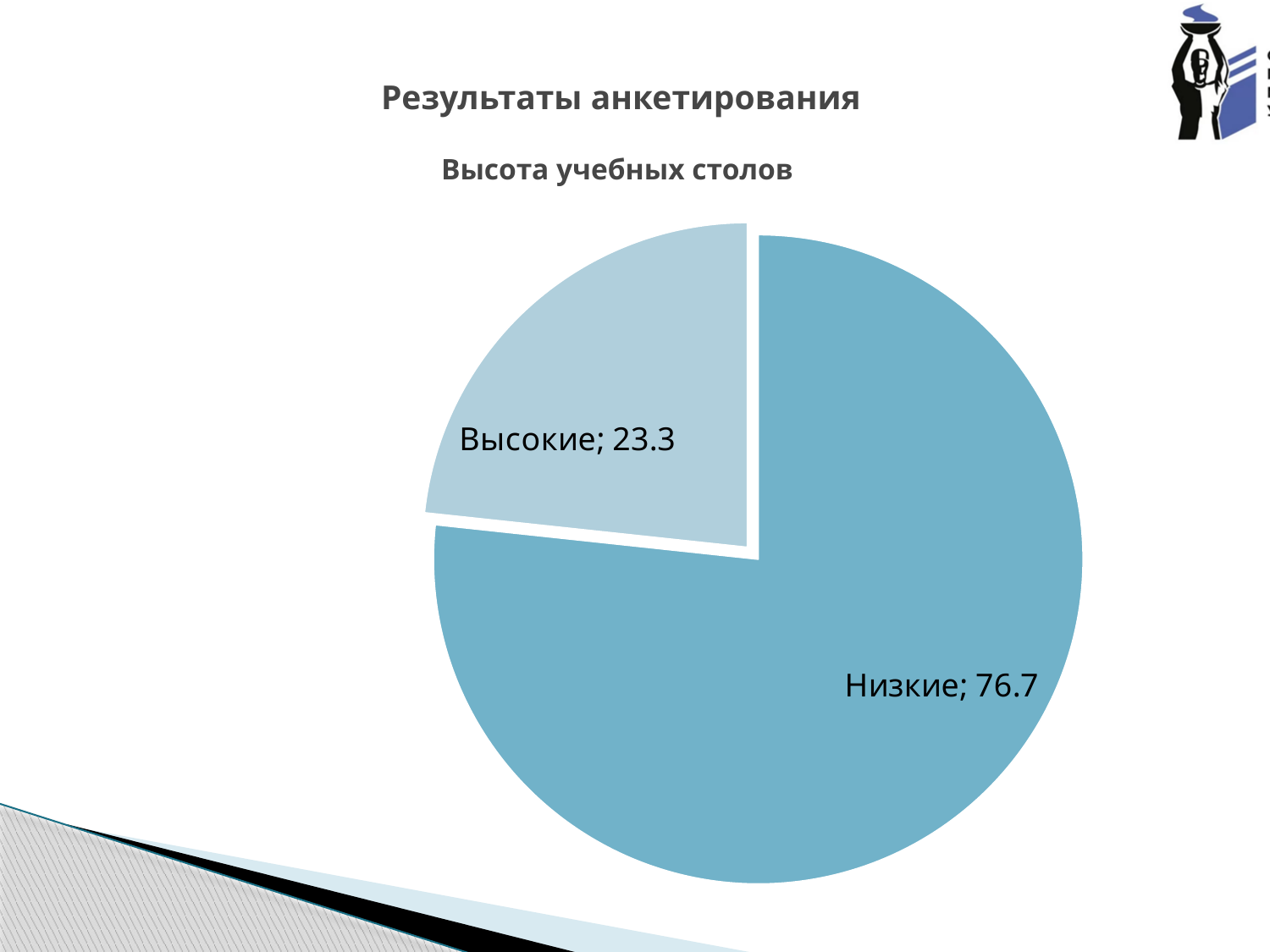
What type of chart is shown on the slide? pie chart What is the difference between the values for Низкие and Высокие? 53.4 How many slices does the pie chart have? 2 Which category has the smallest slice? Высокие What is the total of the two slice values? 100 Which category has the largest slice? Низкие Which slice is pulled out (exploded) from the pie? Высокие What is the value for Высокие? 23.3 What is the value for Низкие? 76.7 What is the title of the chart? Высота учебных столов Which is larger, the value for Высокие or the value for Низкие? Низкие